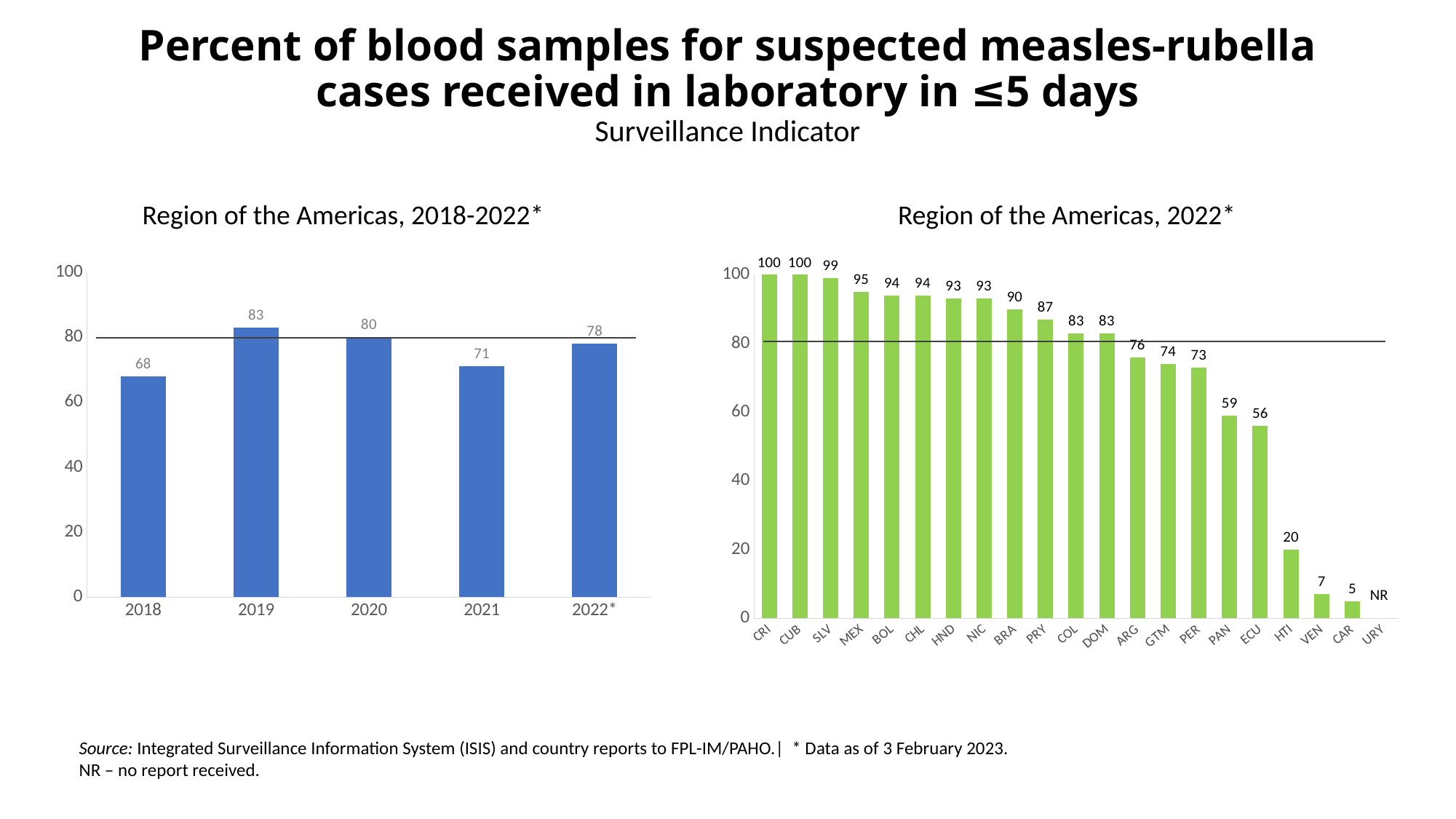
In the 'Region of the Americas, 2022*' chart, do the values rise or fall from left to right along the x axis? fall In the 'Region of the Americas, 2022*' chart, which country is marked NR (no report received)? URY In the 'Region of the Americas, 2018-2022*' chart, how many years are plotted? 5 In the 'Region of the Americas, 2022*' chart, what is the value for BRA? 90 In the 'Region of the Americas, 2022*' chart, what is the value for HTI? 20 In the 'Region of the Americas, 2022*' chart, which country has the lowest plotted value? CAR In the 'Region of the Americas, 2018-2022*' chart, is the value for 2020 larger or smaller than the value for 2022*? larger In the 'Region of the Americas, 2018-2022*' chart, what is the value for 2019? 83 In the 'Region of the Americas, 2018-2022*' chart, which year has the lowest value? 2018 In the 'Region of the Americas, 2022*' chart, what is the difference between the values for PAN and ECU? 3 In the 'Region of the Americas, 2018-2022*' chart, what is the difference between the values for 2019 and 2021? 12 What kind of chart is the 'Region of the Americas, 2022*' chart? bar chart